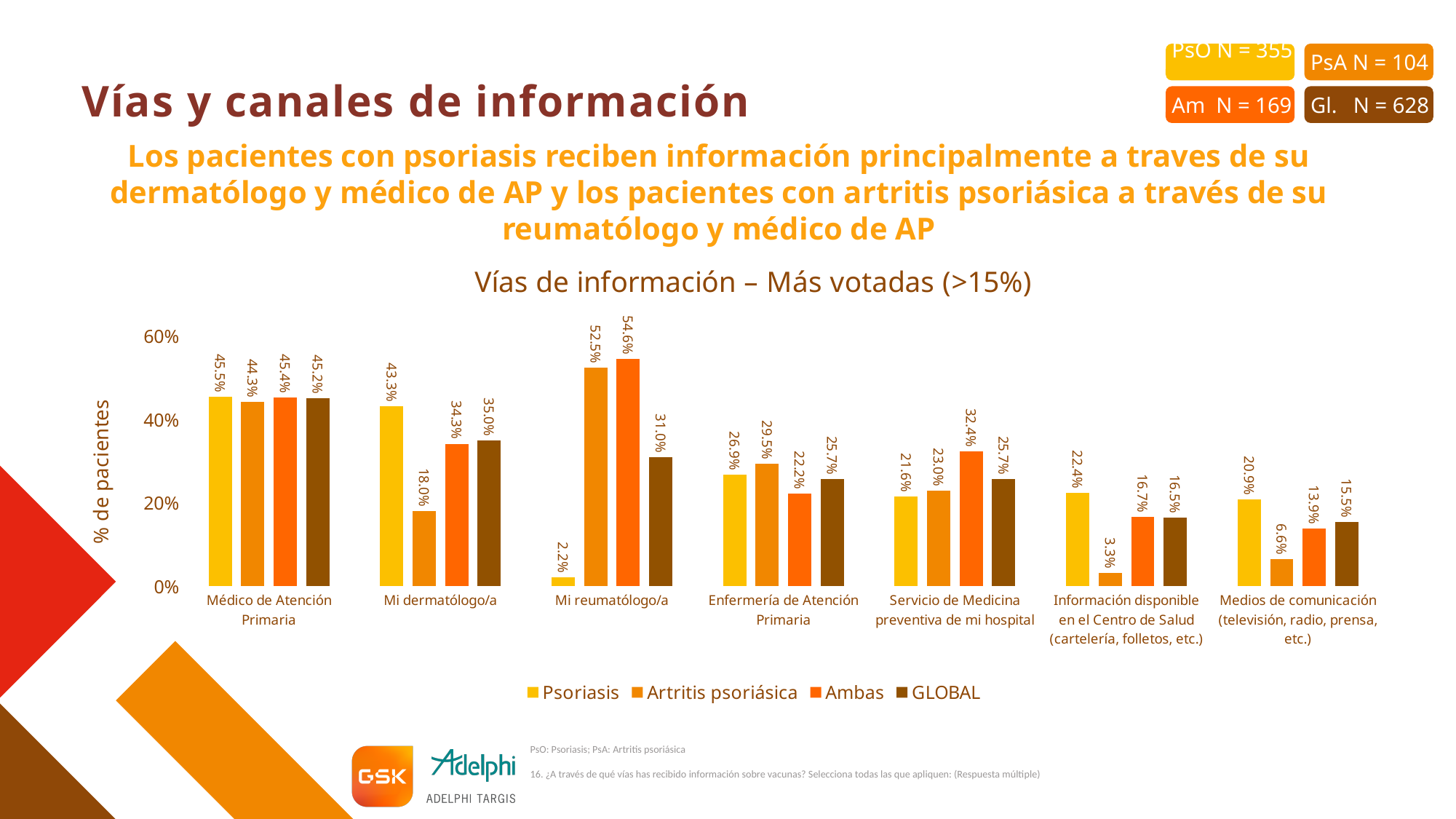
Which category has the lowest value for the Psoriasis series? Mi reumatólogo/a What is the value for Ambas in the 'Mi reumatólogo/a' category? 54.6% What is the title of the chart? Vías de información – Más votadas (>15%) Which category has the highest value for the Artritis psoriásica series? Mi reumatólogo/a What kind of chart is shown on the slide? Bar chart For 'Servicio de Medicina preventiva de mi hospital', which is larger: the Ambas value or the Psoriasis value? Ambas What is the GLOBAL value for 'Médico de Atención Primaria'? 45.2% What is the value for Artritis psoriásica in the 'Medios de comunicación (televisión, radio, prensa, etc.)' category? 6.6% How many categories are shown on the x axis? 7 What is the value for Psoriasis in the 'Mi dermatólogo/a' category? 43.3% What is the difference between the Psoriasis and Artritis psoriásica values for 'Mi dermatólogo/a'? 25.3% How many series does the legend list? 4